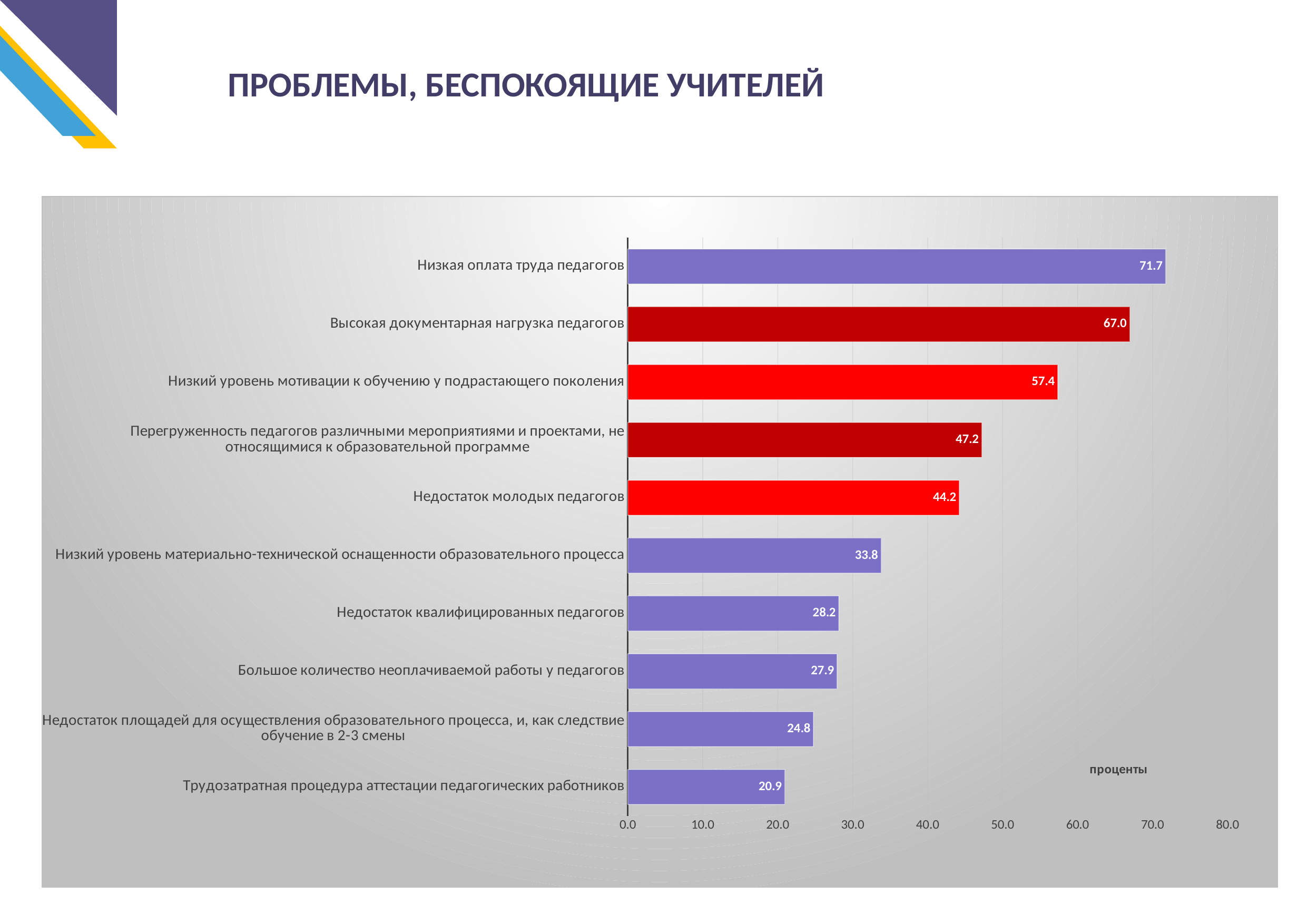
Which category has the highest value? Низкая оплата труда педагогов What is the difference between the values for "Низкая оплата труда педагогов" and "Высокая документарная нагрузка педагогов"? 4.7 What is the title of the slide? ПРОБЛЕМЫ, БЕСПОКОЯЩИЕ УЧИТЕЛЕЙ Which category has the lowest value? Трудозатратная процедура аттестации педагогических работников How many categories are shown in the chart? 10 What is the value for "Трудозатратная процедура аттестации педагогических работников"? 20.9 Which is larger: the value for "Недостаток квалифицированных педагогов" or for "Большое количество неоплачиваемой работы у педагогов"? Недостаток квалифицированных педагогов What unit label is shown near the x axis of the chart? проценты Is the value for "Низкий уровень мотивации к обучению у подрастающего поколения" greater or less than 50.0? greater What is the value for "Недостаток молодых педагогов"? 44.2 What kind of chart is shown on the slide? bar chart What is the value for "Низкая оплата труда педагогов"? 71.7